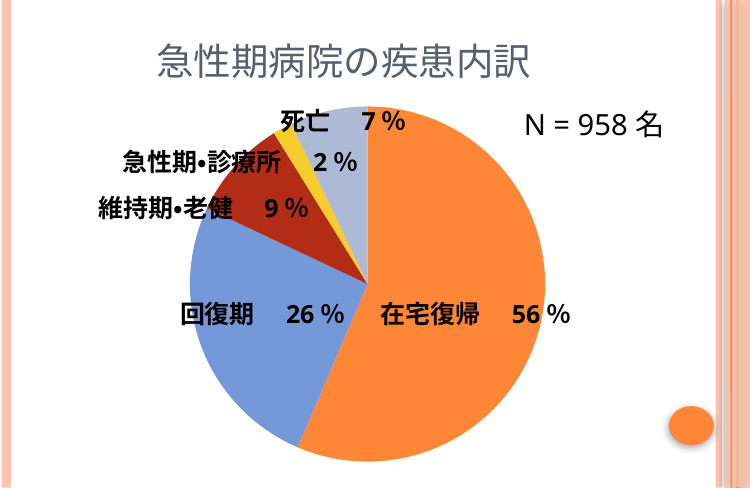
What is the sample size (N) shown on the slide? 958名 Which category has the smallest share of the pie? 急性期•診療所 Which is larger, the share for 維持期•老健 or the share for 死亡? 維持期•老健 What percentage does the 在宅復帰 slice represent? 56％ What is the difference in percentage points between 在宅復帰 and 回復期? 30 What percentage does the 回復期 slice represent? 26％ Which category has the largest share of the pie? 在宅復帰 What percentage does the 死亡 slice represent? 7％ How many slices does the pie chart have? 5 What percentage does the 維持期•老健 slice represent? 9％ What is the title of the chart? 急性期病院の疾患内訳 What kind of chart is shown on the slide? pie chart